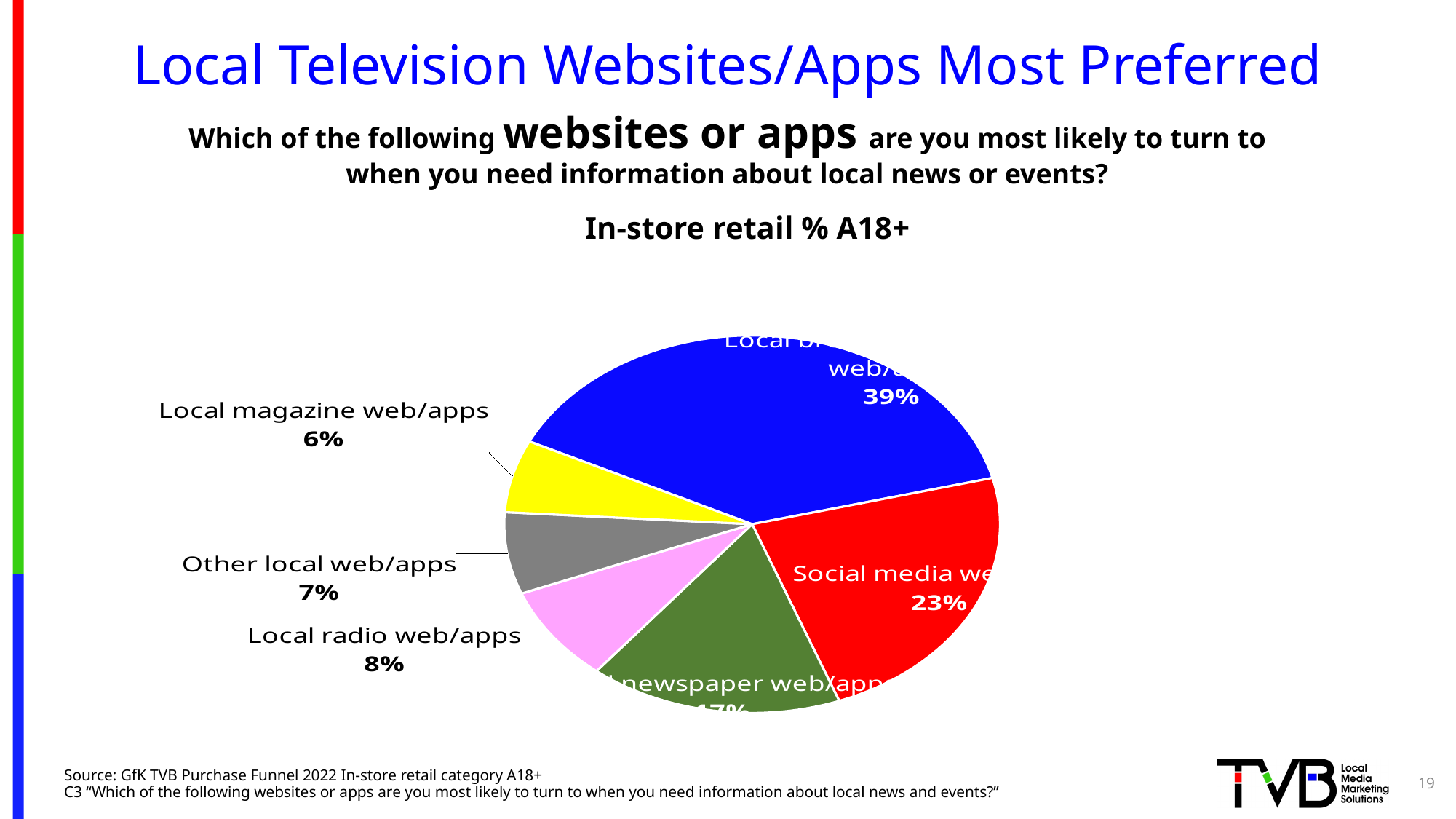
What is the title of the pie chart? In-store retail % A18+ What is the difference between the Social media web/apps value and the Local radio web/apps value? 15% Which is larger, Local radio web/apps or Other local web/apps? Local radio web/apps What is the value for Local magazine web/apps? 6% What is the value for Social media web/apps? 23% What is the value shown on the largest (blue) slice of the pie? 39% What is the value for Local radio web/apps? 8% What is the value for Other local web/apps? 7% Which category has the smallest slice of the pie? Local magazine web/apps How many slices does the pie chart have? 6 What kind of chart is shown on the slide? pie chart What colour is the Local magazine web/apps slice? yellow